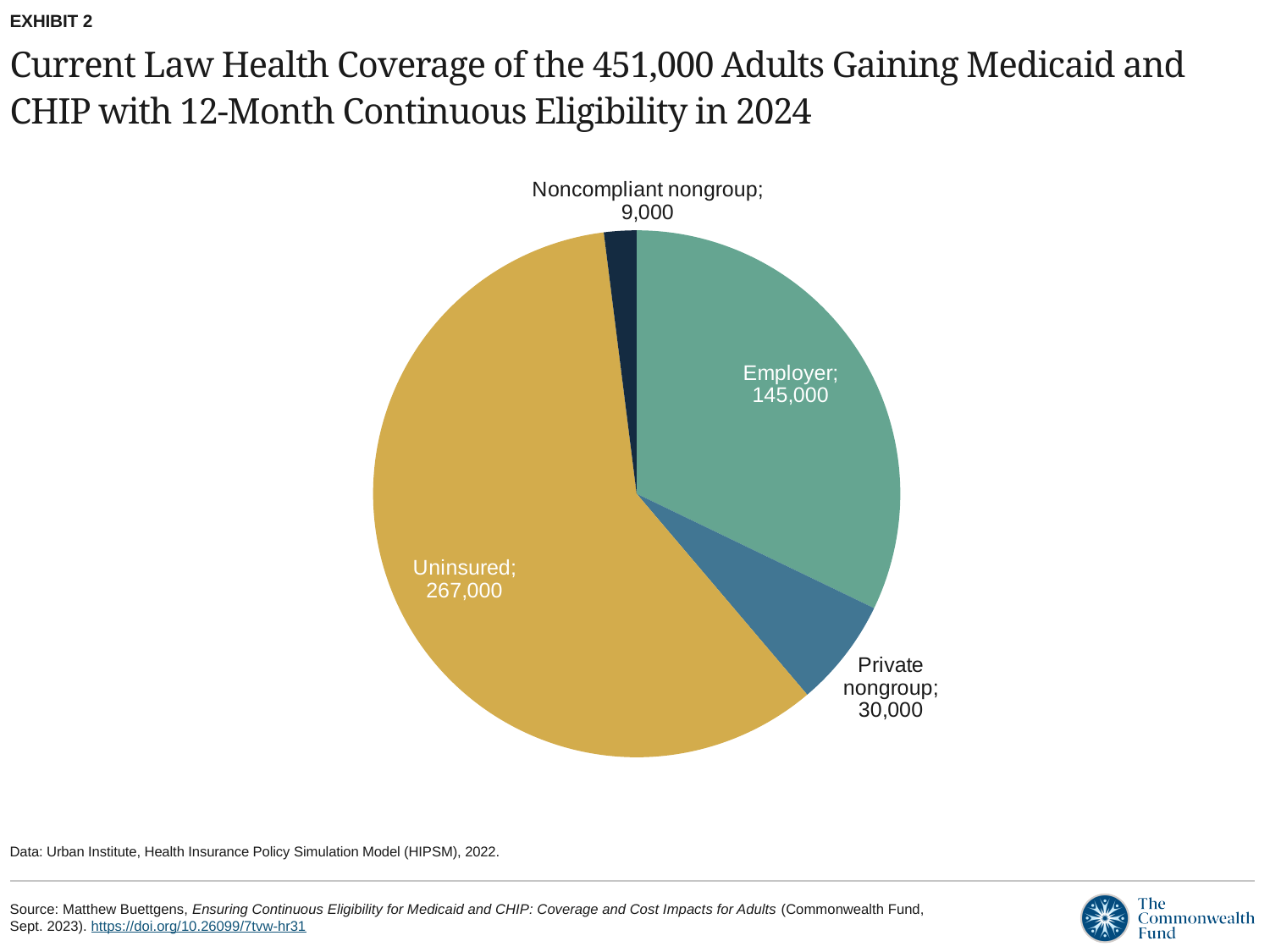
Which category has the largest slice of the pie? Uninsured What kind of chart is shown on the slide? Pie chart To the nearest whole percent, what share of the 451,000 adults does the Uninsured slice represent? 59% What is the value for the Private nongroup slice? 30,000 What is the value for the Uninsured slice? 267,000 What is the difference between the Uninsured and Employer values? 122,000 Which is larger, the Employer slice or the Private nongroup slice? Employer What is the difference between the Private nongroup and Noncompliant nongroup values? 21,000 How many slices does the pie chart have? 4 What is the value for the Employer slice? 145,000 Which category has the smallest slice of the pie? Noncompliant nongroup What is the value for the Noncompliant nongroup slice? 9,000